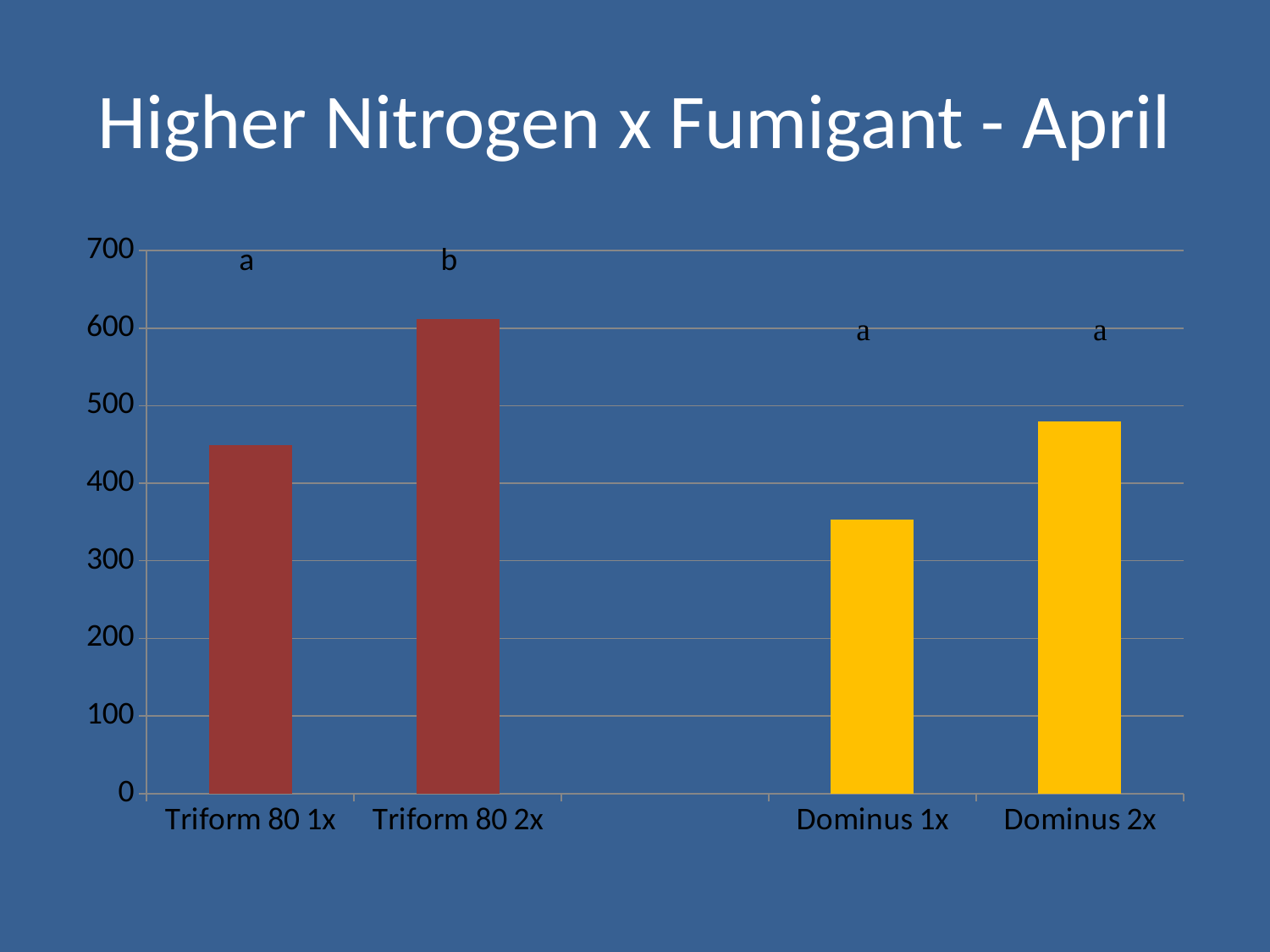
Is the value for Triform 80 2x greater or less than 500? greater What kind of chart is shown on the slide? bar chart Which category has the highest bar? Triform 80 2x Which category has the lowest bar? Dominus 1x Is the value for Dominus 2x greater or less than 400? greater Which is larger, the value for Triform 80 2x or the value for Dominus 2x? Triform 80 2x What colour are the bars for the Dominus treatments? yellow Is the value for Triform 80 1x greater or less than 400? greater What is the title of the chart on the slide? Higher Nitrogen x Fumigant - April Which is larger, the value for Triform 80 1x or the value for Dominus 1x? Triform 80 1x How many categories (bars) are plotted in the chart? 4